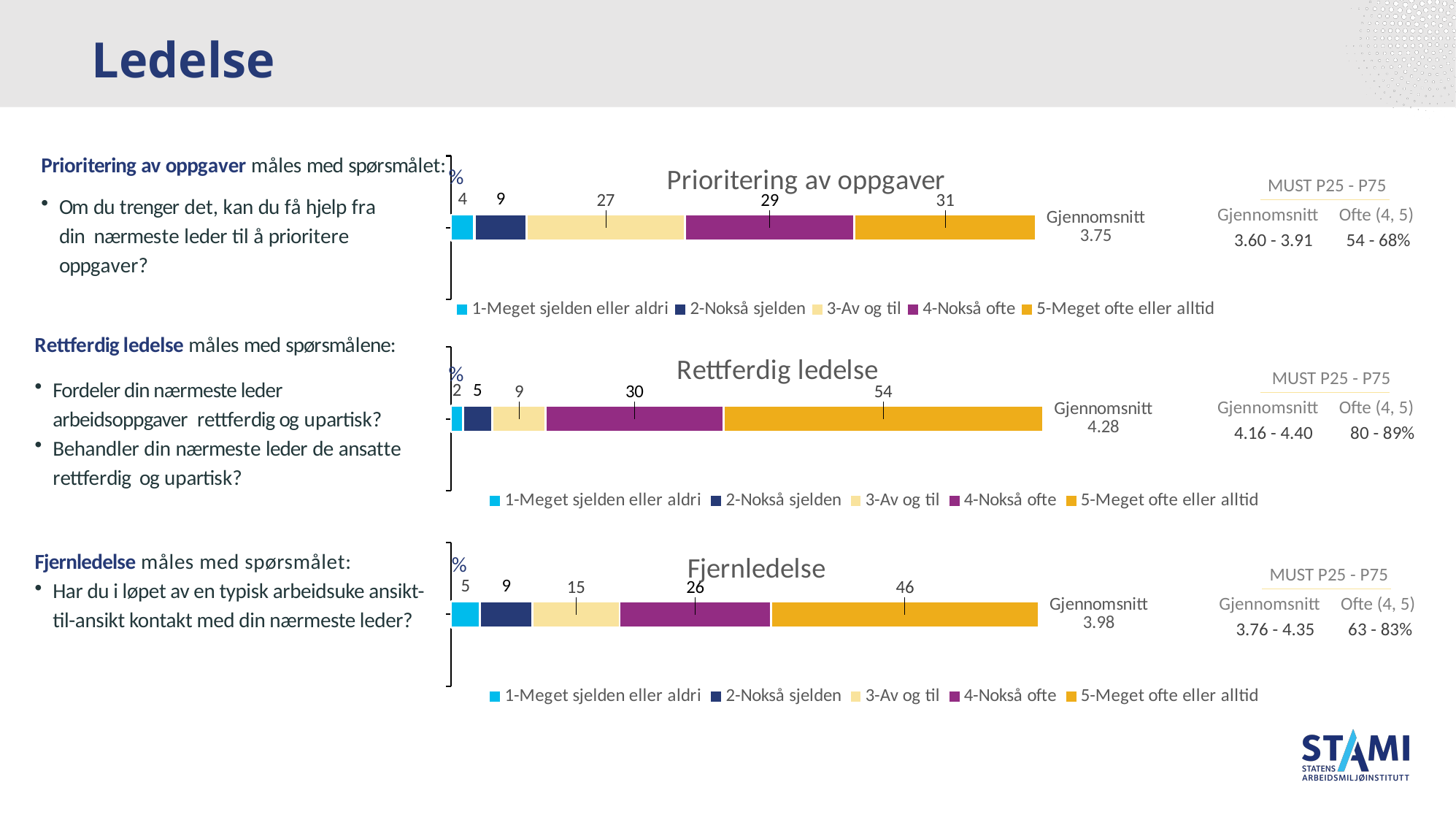
How many series does the legend of the 'Fjernledelse' chart list? 5 In the 'Rettferdig ledelse' chart, which response category has the highest value? 5-Meget ofte eller alltid In the 'Prioritering av oppgaver' chart, what is the difference between the values for '4-Nokså ofte' and '3-Av og til'? 2 In the 'Prioritering av oppgaver' chart, what is the value for '5-Meget ofte eller alltid'? 31 In the 'Fjernledelse' chart, what is the difference between the values for '5-Meget ofte eller alltid' and '4-Nokså ofte'? 20 In the 'Fjernledelse' chart, what is the value for '3-Av og til'? 15 In the 'Rettferdig ledelse' chart, what is the value for '4-Nokså ofte'? 30 In the 'Prioritering av oppgaver' chart, which response category has the lowest value? 1-Meget sjelden eller aldri What kind of chart is the 'Prioritering av oppgaver' chart? Stacked bar chart In the 'Rettferdig ledelse' chart, what is the total of the stacked bar? 100 In the 'Rettferdig ledelse' chart, which is larger: the value for '3-Av og til' or the value for '2-Nokså sjelden'? 3-Av og til What is the 'Gjennomsnitt' value shown next to the 'Fjernledelse' chart? 3.98